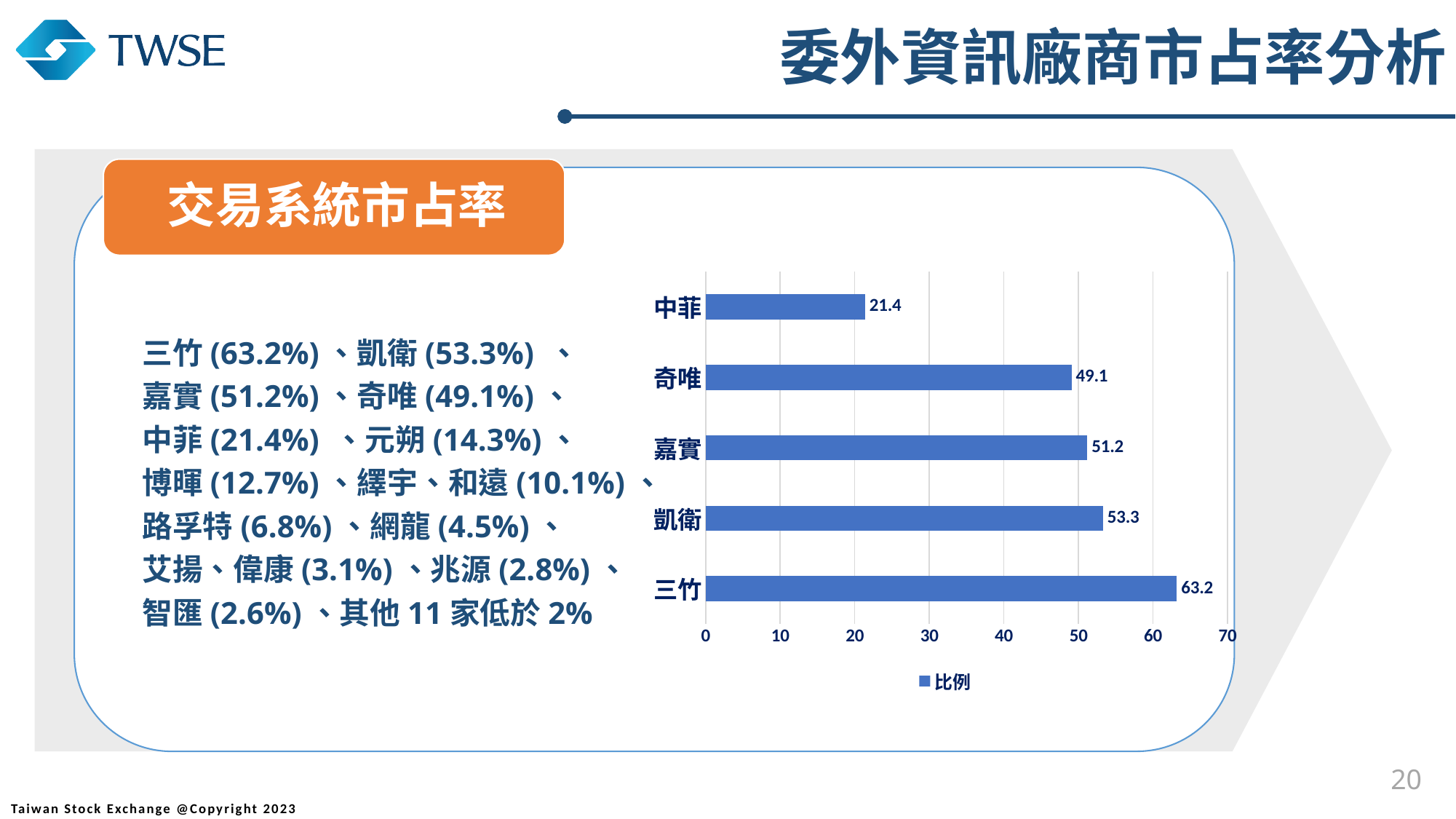
What kind of chart is shown on the slide? bar chart Is the value for 奇唯 greater or less than 40? greater What series name does the chart legend show? 比例 Which category has the lowest value in the bar chart? 中菲 Which is larger, the value for 凱衛 or the value for 嘉實? 凱衛 What is the value for 中菲 in the bar chart? 21.4 What is the value for 三竹 in the bar chart? 63.2 What is the value for 奇唯 in the bar chart? 49.1 Which category has the highest value in the bar chart? 三竹 What is the difference between the values for 三竹 and 凱衛? 9.9 How many categories are shown in the bar chart? 5 What is the difference between the values for 嘉實 and 奇唯? 2.1